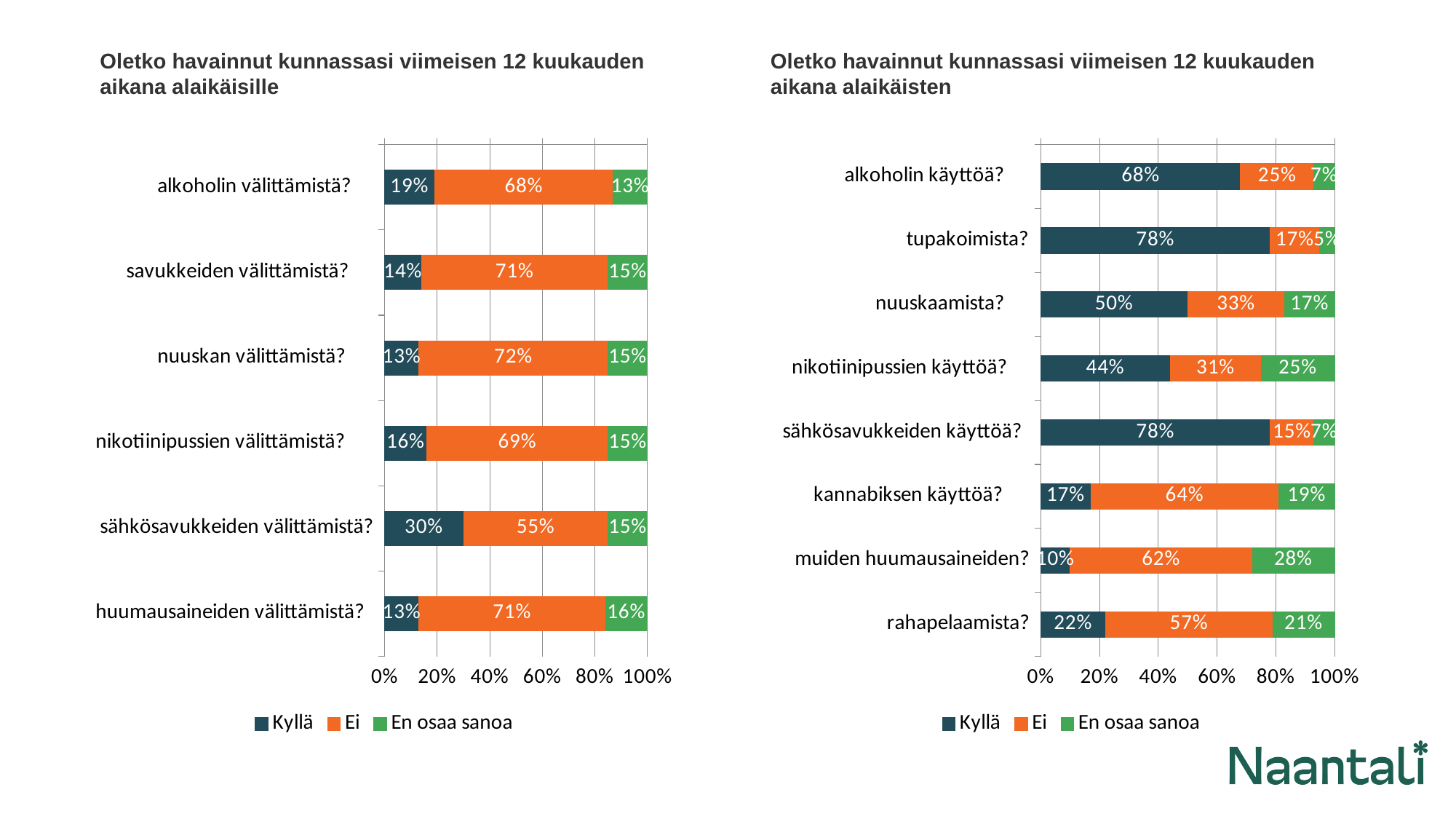
In the right chart ("...aikana alaikäisten"), what is the En osaa sanoa value for muiden huumausaineiden? 28% In the left chart ("...aikana alaikäisille"), how many categories are shown? 6 In the right chart ("...aikana alaikäisten"), which is larger: the Kyllä value for alkoholin käyttöä or the Kyllä value for nuuskaamista? alkoholin käyttöä In the left chart ("...aikana alaikäisille"), what is the Kyllä value for sähkösavukkeiden välittämistä? 30% How many series does the legend of the right chart ("...aikana alaikäisten") list? 3 In the left chart ("...aikana alaikäisille"), which category has the highest Kyllä value? sähkösavukkeiden välittämistä? In the left chart ("...aikana alaikäisille"), what is the Ei value for nuuskan välittämistä? 72% In the right chart ("...aikana alaikäisten"), what is the Kyllä value for nuuskaamista? 50% In the left chart ("...aikana alaikäisille"), what is the difference between the Ei values for savukkeiden välittämistä and sähkösavukkeiden välittämistä? 16% What type of chart is the left chart ("...aikana alaikäisille")? Stacked bar chart In the right chart ("...aikana alaikäisten"), which category has the lowest Kyllä value? muiden huumausaineiden? In the right chart ("...aikana alaikäisten"), how many categories are shown? 8